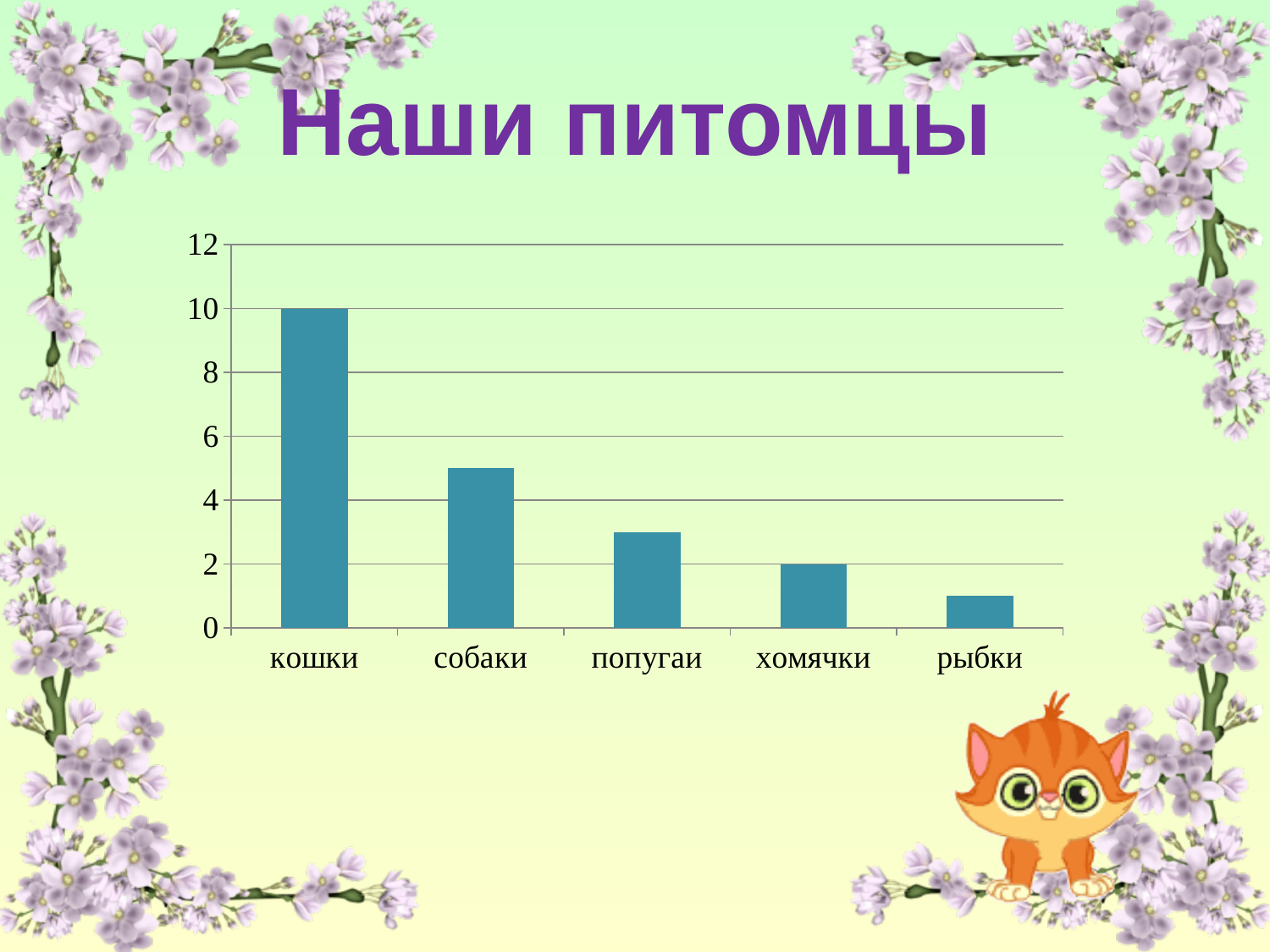
What is the value for хомячки? 2 How many categories are shown on the x axis of the chart? 5 What kind of chart is shown on the slide? bar chart Which category has the lowest value? рыбки Is the value for попугаи greater or less than 4? less What is the title of the slide with the chart? Наши питомцы What is the difference between the value for кошки and the value for хомячки? 8 Is the value for рыбки greater or less than 2? less Is the value for собаки greater or less than 4? greater What is the value for кошки? 10 Which is larger, the value for собаки or the value for попугаи? собаки Which category has the highest value? кошки